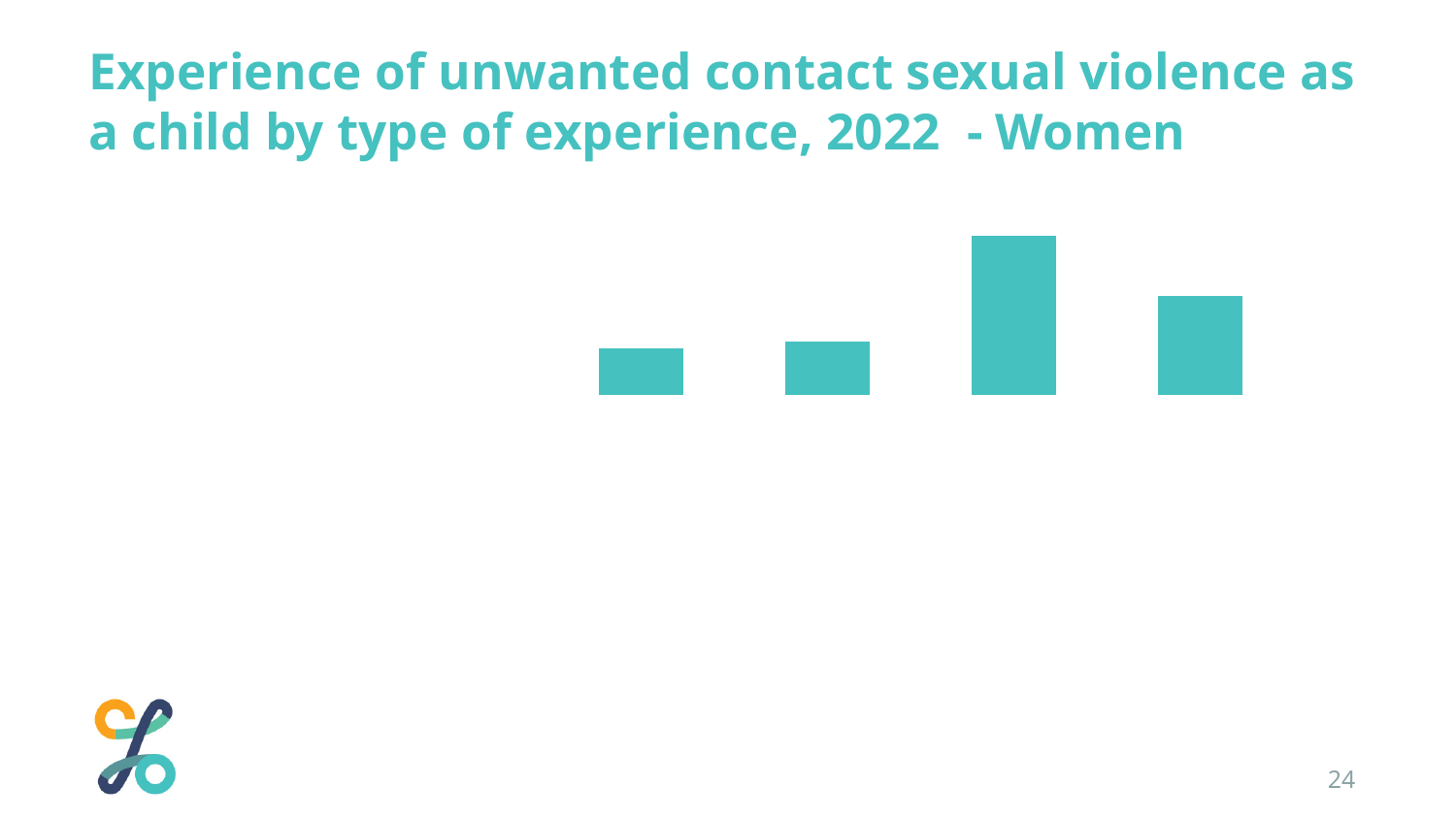
What colour are the bars in the chart? teal What kind of chart is shown on the slide? bar chart Which bar is the tallest in the chart, counting from the left? the third bar How many bars are plotted in the chart? 4 Which bar is the shortest in the chart, counting from the left? the first bar Is the second bar from the left taller or shorter than the third bar? shorter What is the title of the slide containing the chart? Experience of unwanted contact sexual violence as a child by type of experience, 2022 - Women Is the fourth bar from the left taller or shorter than the first bar? taller Is the third bar from the left taller or shorter than the fourth bar? taller